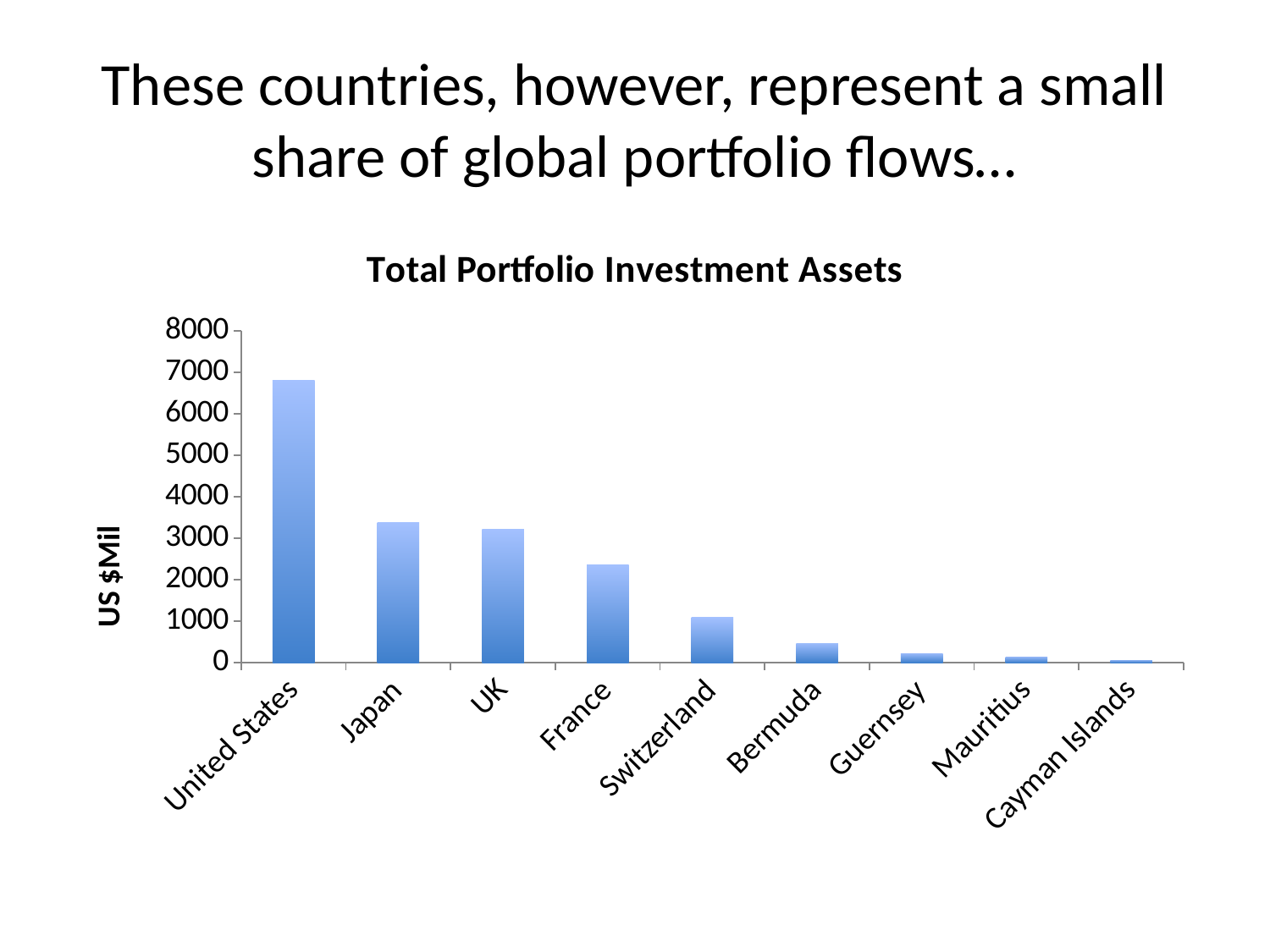
How many countries are shown on the x axis of the chart? 9 Which has a larger value, France or Switzerland? France What is the label on the vertical axis of the chart? US $Mil Which country has the highest total portfolio investment assets? United States Which country has the lowest total portfolio investment assets? Cayman Islands Is the value for France greater or less than 2000? greater What kind of chart is shown on the slide? Bar chart What is the title of the chart? Total Portfolio Investment Assets Is the value for United States greater or less than 6000? greater Do the values rise or fall moving from left to right along the x axis? Fall Is the value for Bermuda greater or less than 1000? less